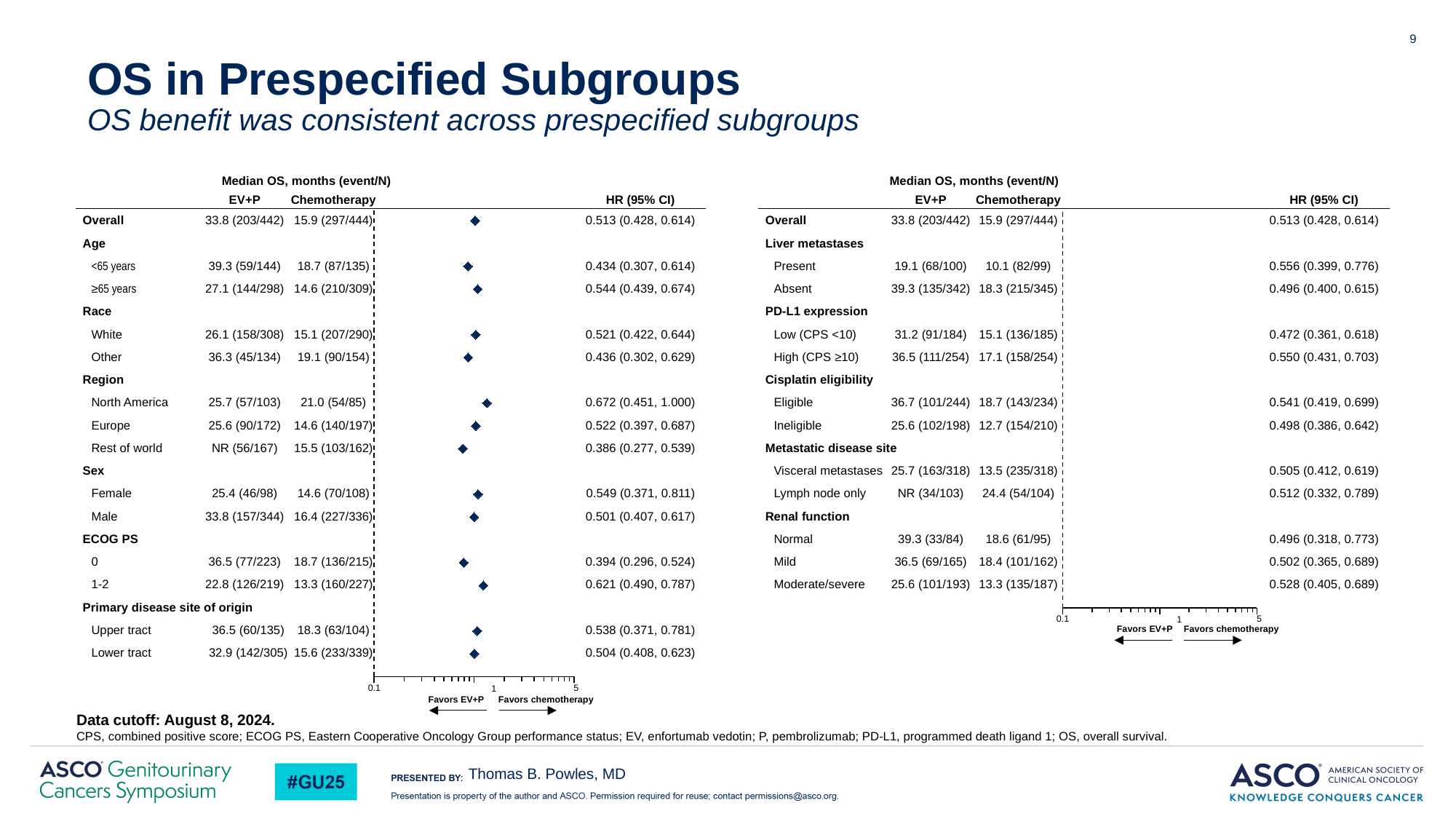
On the left forest plot, what is the HR (95% CI) for the Rest of world region subgroup? 0.386 (0.277, 0.539) On the left forest plot, what does the arrow pointing to the left of the x axis indicate? Favors EV+P On the left forest plot, which subgroup has the highest hazard ratio? North America On the right forest plot, what is the HR (95% CI) for patients with liver metastases present? 0.556 (0.399, 0.776) On the right forest plot, which subgroup has the lowest hazard ratio? Low (CPS <10) On the left forest plot, which subgroup has the lowest hazard ratio? Rest of world On the left forest plot, what is the HR (95% CI) for the Overall population? 0.513 (0.428, 0.614) What kind of chart is shown on the slide? Forest plot On the left forest plot, is the hazard ratio for North America greater or less than 1? less How many subgroup rows (including Overall) are plotted on the left forest plot? 14 On the left forest plot, is the hazard ratio for ECOG PS 0 or ECOG PS 1-2 larger? ECOG PS 1-2 On the left forest plot, what is the difference in median OS between EV+P and chemotherapy for the Overall population? 17.9 months